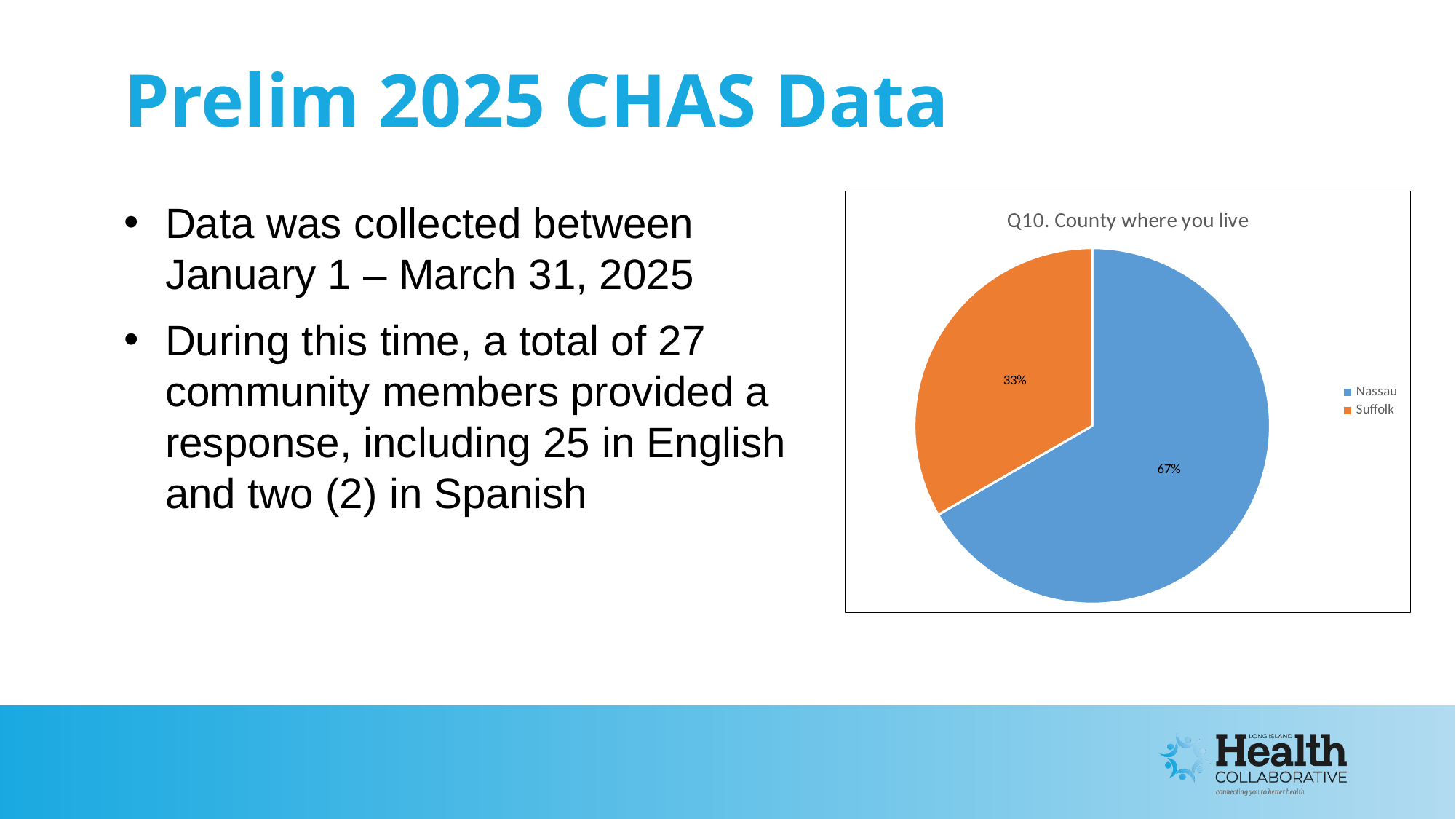
What is the title of the chart? Q10. County where you live Which slice is larger, Nassau or Suffolk? Nassau What is the difference in percentage points between the Nassau and Suffolk slices? 34 What colour is the Suffolk slice in the pie chart? Orange What share of the pie does Nassau represent? 67% How many categories are shown in the pie chart? 2 What kind of chart is shown on the slide? Pie chart What share of the pie does Suffolk represent? 33% Which county has the largest slice of the pie? Nassau How many entries does the chart legend list? 2 Which county has the smallest slice of the pie? Suffolk